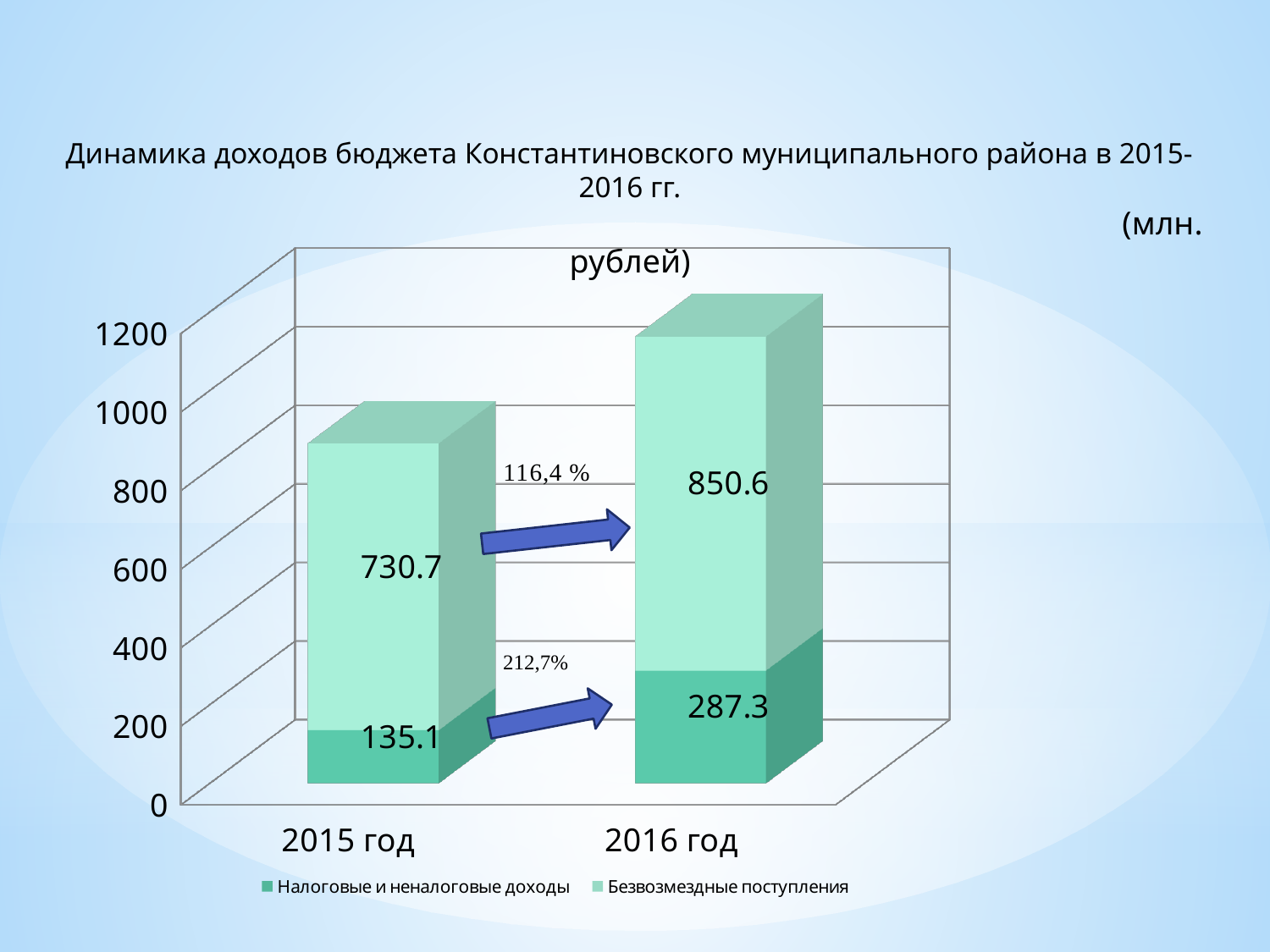
What is the value of Безвозмездные поступления for 2015 год? 730.7 What kind of chart is shown on the slide? Stacked bar chart What is the total of the stacked bar for 2016 год? 1137.9 What is the total of the stacked bar for 2015 год? 865.8 Which year has the larger value for Безвозмездные поступления, 2015 год or 2016 год? 2016 год What is the value of Налоговые и неналоговые доходы for 2015 год? 135.1 What is the value of Безвозмездные поступления for 2016 год? 850.6 By how much did Налоговые и неналоговые доходы increase from 2015 год to 2016 год? 152.2 What is the value of Налоговые и неналоговые доходы for 2016 год? 287.3 How many series does the legend list? 2 Do the total budget revenues rise or fall from 2015 год to 2016 год? Rise How many categories are shown on the x axis? 2